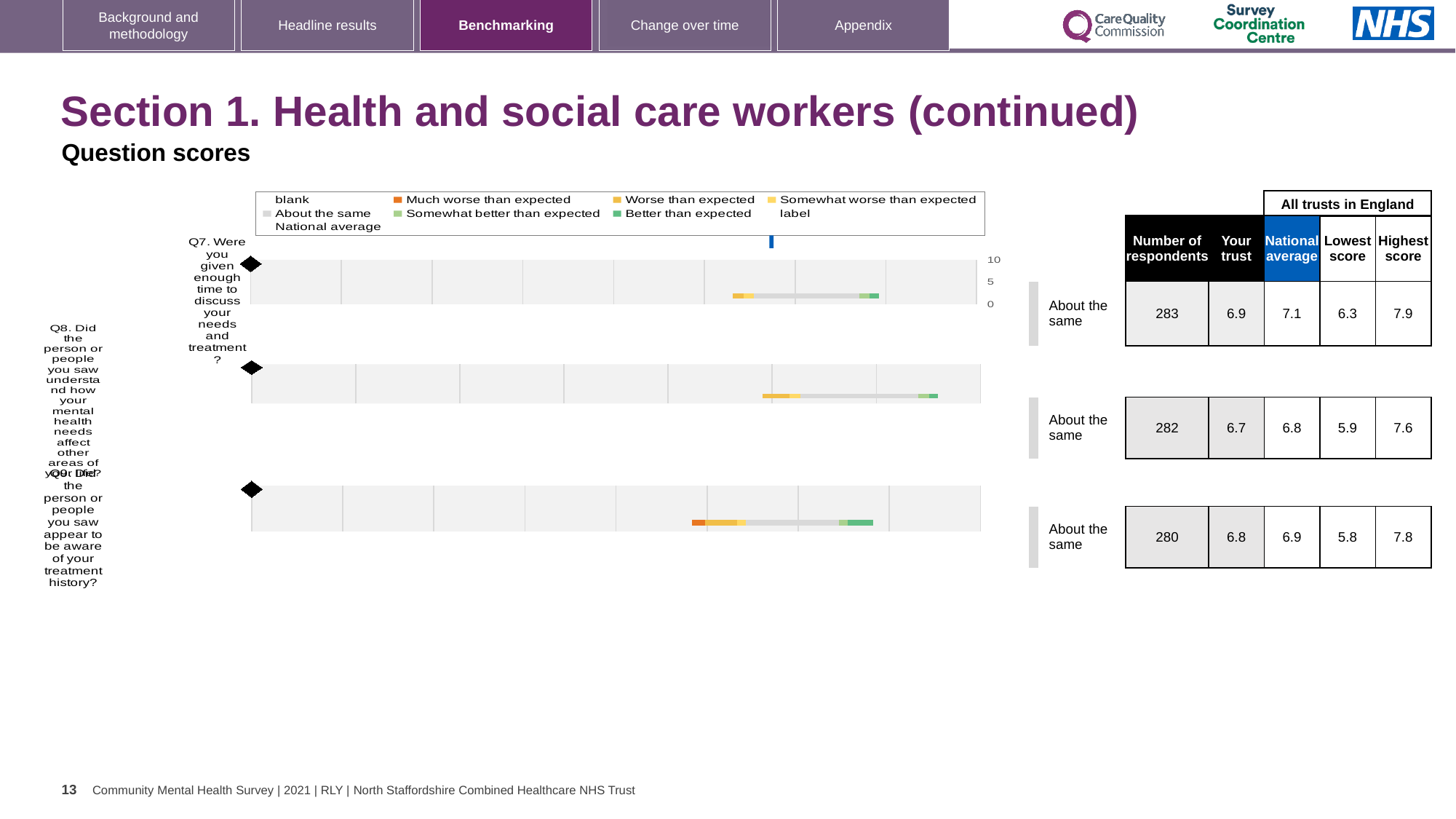
Which question has the lowest 'Lowest score' across all trusts in England? Q9 What is the national average score for Q8 (Did the person or people you saw understand how your mental health needs affect other areas of your life?)? 6.8 For Q7, which is larger: the 'Your trust' score or the national average? National average What type of chart is used to show the question scores on this slide? Bar chart How many questions are charted on this slide? 3 How many respondents answered Q9 (Did the person or people you saw appear to be aware of your treatment history?)? 280 What is the lowest score among all trusts in England for Q9? 5.8 What is the 'Your trust' score for Q7 (Were you given enough time to discuss your needs and treatment?)? 6.9 Which question has the highest 'Your trust' score on this slide? Q7 For Q8, what is the difference between the highest score (7.6) and the lowest score (5.9) across all trusts in England? 1.7 What is the highest score among all trusts in England for Q7? 7.9 What benchmark category is shown for Q8 (Did the person or people you saw understand how your mental health needs affect other areas of your life?)? About the same